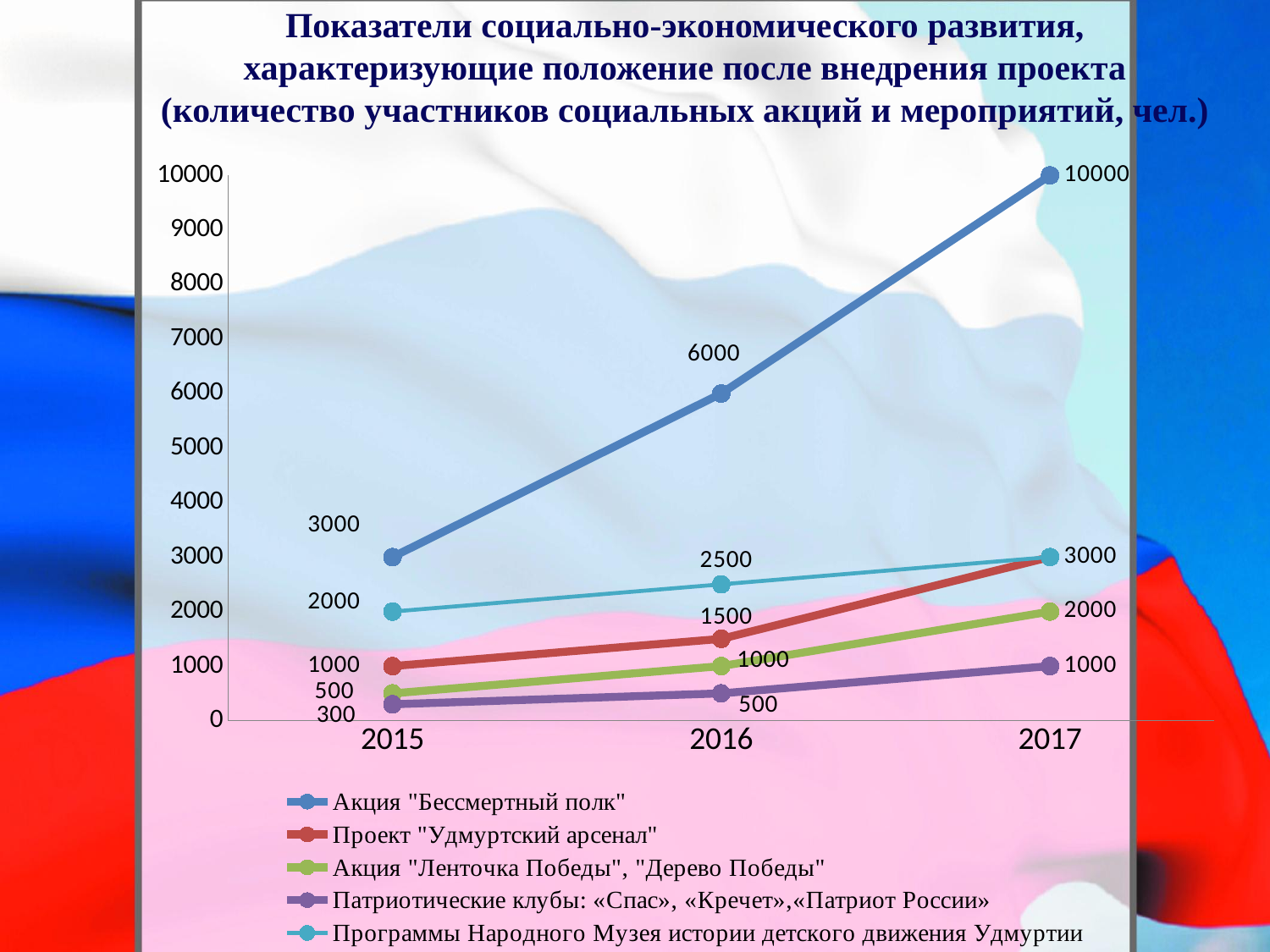
What is the value for Акция "Бессмертный полк" in 2017? 10000 In 2016, which is larger: Программы Народного Музея истории детского движения Удмуртии or Проект "Удмуртский арсенал"? Программы Народного Музея истории детского движения Удмуртии How many years are shown on the x axis? 3 Which series has the highest value in 2017? Акция "Бессмертный полк" What is the value for Акция "Ленточка Победы", "Дерево Победы" in 2017? 2000 How many series does the legend list? 5 By how much did the value for Акция "Бессмертный полк" increase from 2015 to 2017? 7000 What is the value for Программы Народного Музея истории детского движения Удмуртии in 2015? 2000 Does the value for Акция "Бессмертный полк" rise or fall from 2015 to 2017? rise Which series has the lowest value in 2015? Патриотические клубы: «Спас», «Кречет», «Патриот России» What kind of chart is shown on the slide? line chart What is the value for Акция "Бессмертный полк" in 2016? 6000